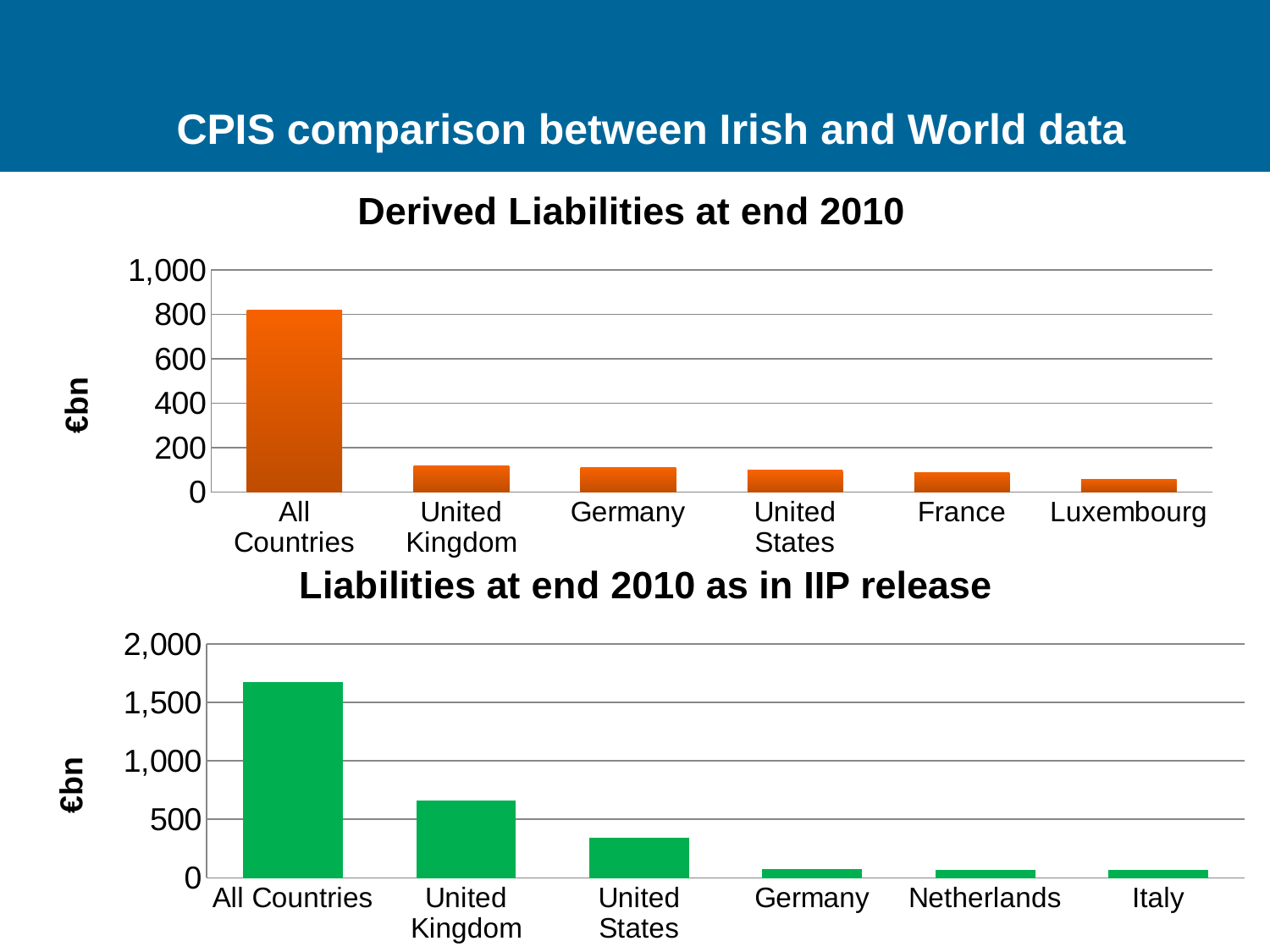
What is the y-axis label of the 'Liabilities at end 2010 as in IIP release' chart? €bn In the 'Derived Liabilities at end 2010' chart, which category has the highest value? All Countries In the 'Derived Liabilities at end 2010' chart, which category has the lowest value? Luxembourg In the 'Liabilities at end 2010 as in IIP release' chart, which is larger, the value for United Kingdom or the value for United States? United Kingdom In the 'Derived Liabilities at end 2010' chart, is the value for All Countries greater or less than 800? greater How many categories are shown in the 'Derived Liabilities at end 2010' chart? 6 In the 'Derived Liabilities at end 2010' chart, is the value for United Kingdom greater or less than 200? less In the 'Liabilities at end 2010 as in IIP release' chart, which category has the highest value? All Countries How many categories are shown in the 'Liabilities at end 2010 as in IIP release' chart? 6 In the 'Liabilities at end 2010 as in IIP release' chart, is the value for United States greater or less than 500? less What type of chart is the 'Derived Liabilities at end 2010' chart? bar chart